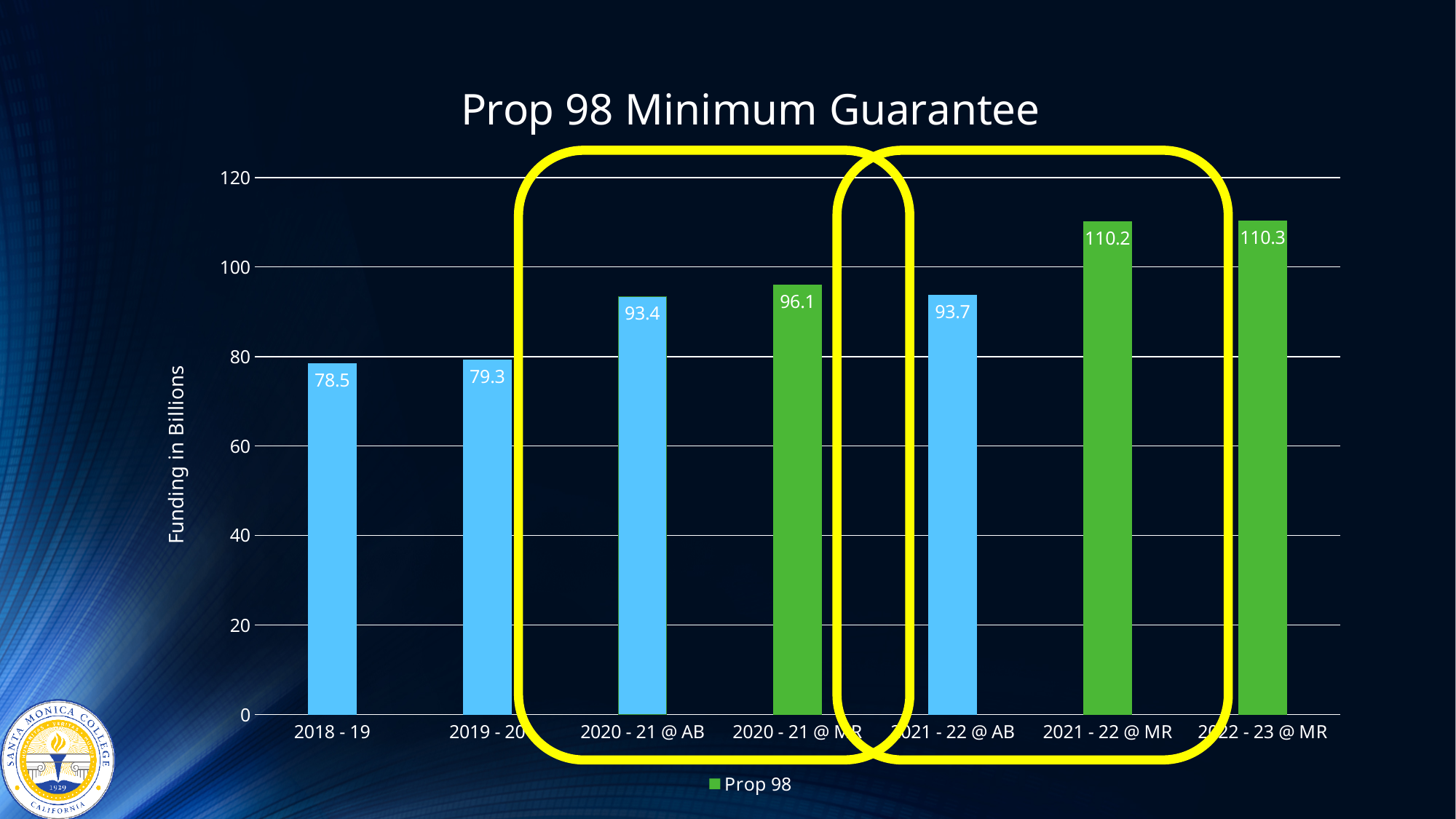
Is the value for 2021 - 22 @ MR greater or less than 100? greater What is the value for 2018 - 19? 78.5 How many bars are shown in the chart? 7 What is the value for 2020 - 21 @ AB? 93.4 What is the label on the vertical axis? Funding in Billions What is the value for 2021 - 22 @ MR? 110.2 Is the value for 2018 - 19 greater or less than 80? less Which is larger, the value for 2019 - 20 or the value for 2020 - 21 @ AB? 2020 - 21 @ AB How many series does the legend list? 1 What is the difference between the values for 2020 - 21 @ MR and 2020 - 21 @ AB? 2.7 What is the difference between the values for 2021 - 22 @ MR and 2021 - 22 @ AB? 16.5 What kind of chart is shown on the slide? bar chart